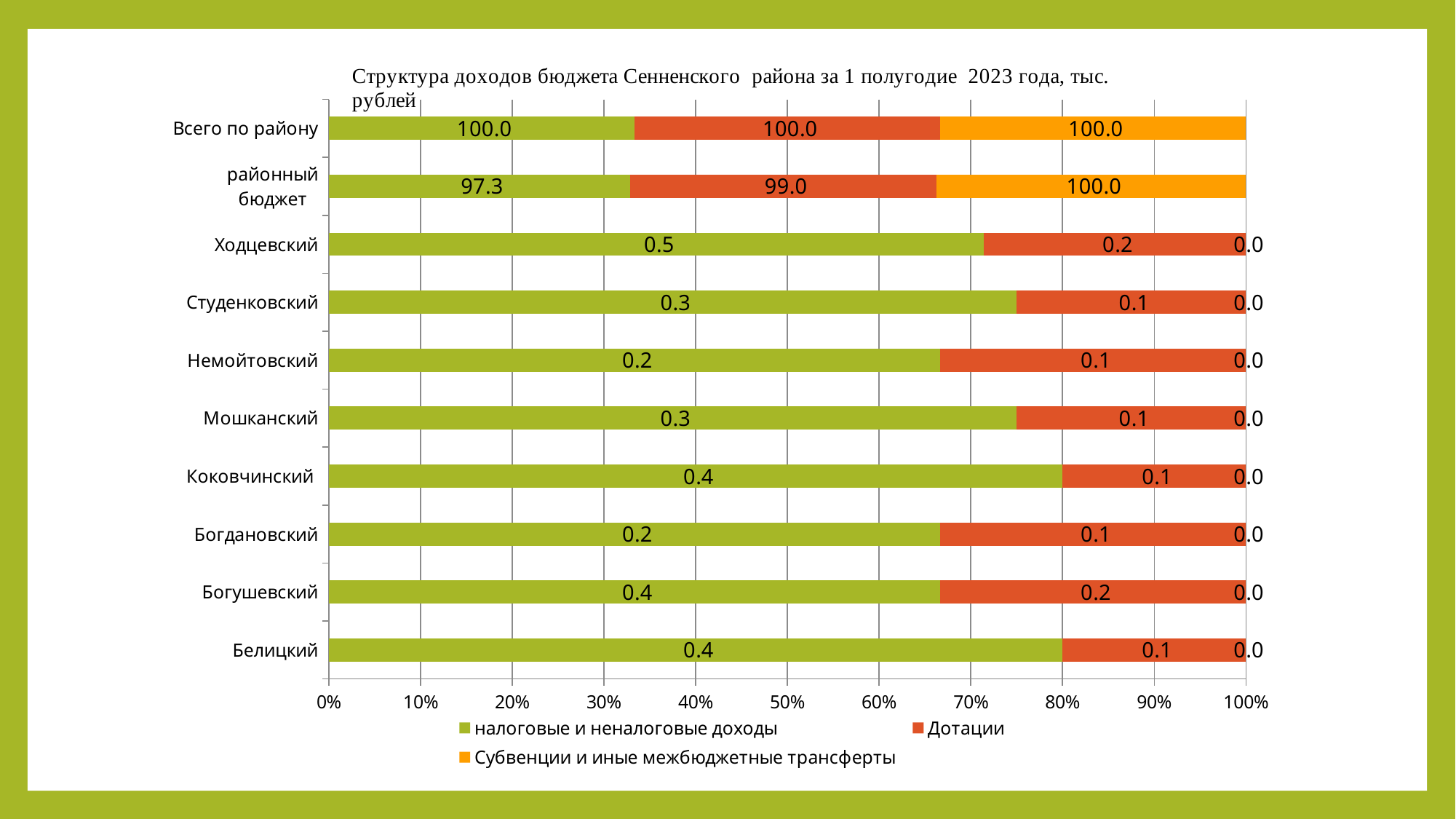
What is the difference between 'Дотации' and 'налоговые и неналоговые доходы' for 'районный бюджет'? 1.7 What is the value of 'Дотации' for 'районный бюджет'? 99.0 What is the total of the three labelled values for 'Ходцевский'? 0.7 What is the value of 'налоговые и неналоговые доходы' for 'Ходцевский'? 0.5 What is the value of 'налоговые и неналоговые доходы' for 'районный бюджет'? 97.3 Among the rural councils (excluding 'Всего по району' and 'районный бюджет'), which has the highest value of 'налоговые и неналоговые доходы'? Ходцевский What type of chart is shown on the slide? stacked bar chart How many categories are shown on the vertical axis? 10 Which is larger for 'Коковчинский': 'налоговые и неналоговые доходы' or 'Дотации'? налоговые и неналоговые доходы What is the value of 'Дотации' for 'Богушевский'? 0.2 What is the value of 'Субвенции и иные межбюджетные трансферты' for 'Белицкий'? 0.0 How many series does the legend list? 3